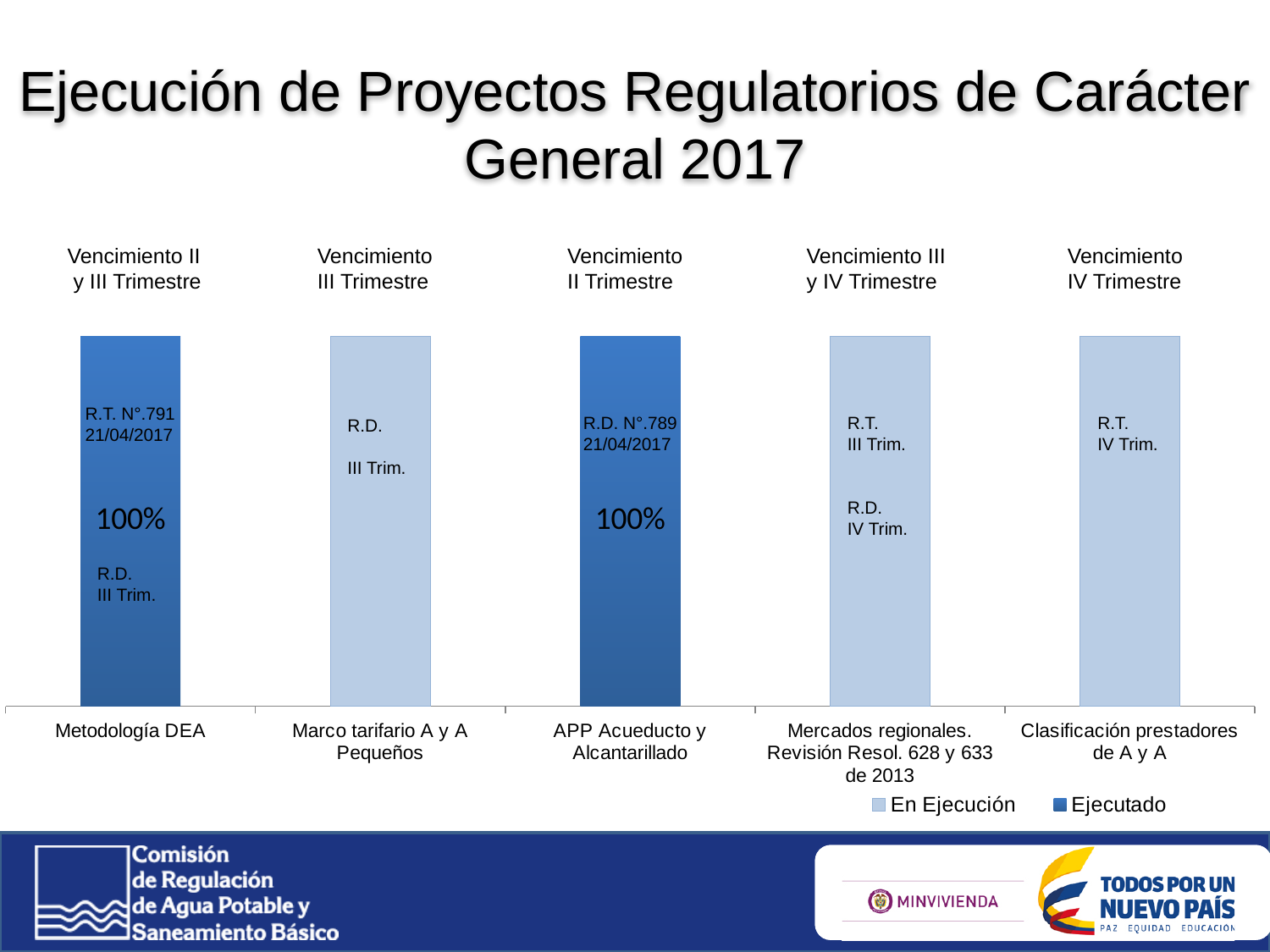
What kind of chart is shown on the slide? bar chart What resolution number and date are printed on the bar for APP Acueducto y Alcantarillado? R.D. N°.789 21/04/2017 What percentage is printed on the bar for APP Acueducto y Alcantarillado? 100% What resolution number and date are printed on the bar for Metodología DEA? R.T. N°.791 21/04/2017 Which series (legend entry) does the bar for Marco tarifario A y A Pequeños belong to? En Ejecución What percentage is printed on the bar for Metodología DEA? 100% Which series (legend entry) does the bar for Metodología DEA belong to? Ejecutado How many categories (projects) are shown along the x axis of the chart? 5 How many series does the chart legend list? 2 How many bars in the chart are shown as Ejecutado (dark blue)? 2 What are the two series named in the chart legend? En Ejecución and Ejecutado What is the title of the slide containing the chart? Ejecución de Proyectos Regulatorios de Carácter General 2017